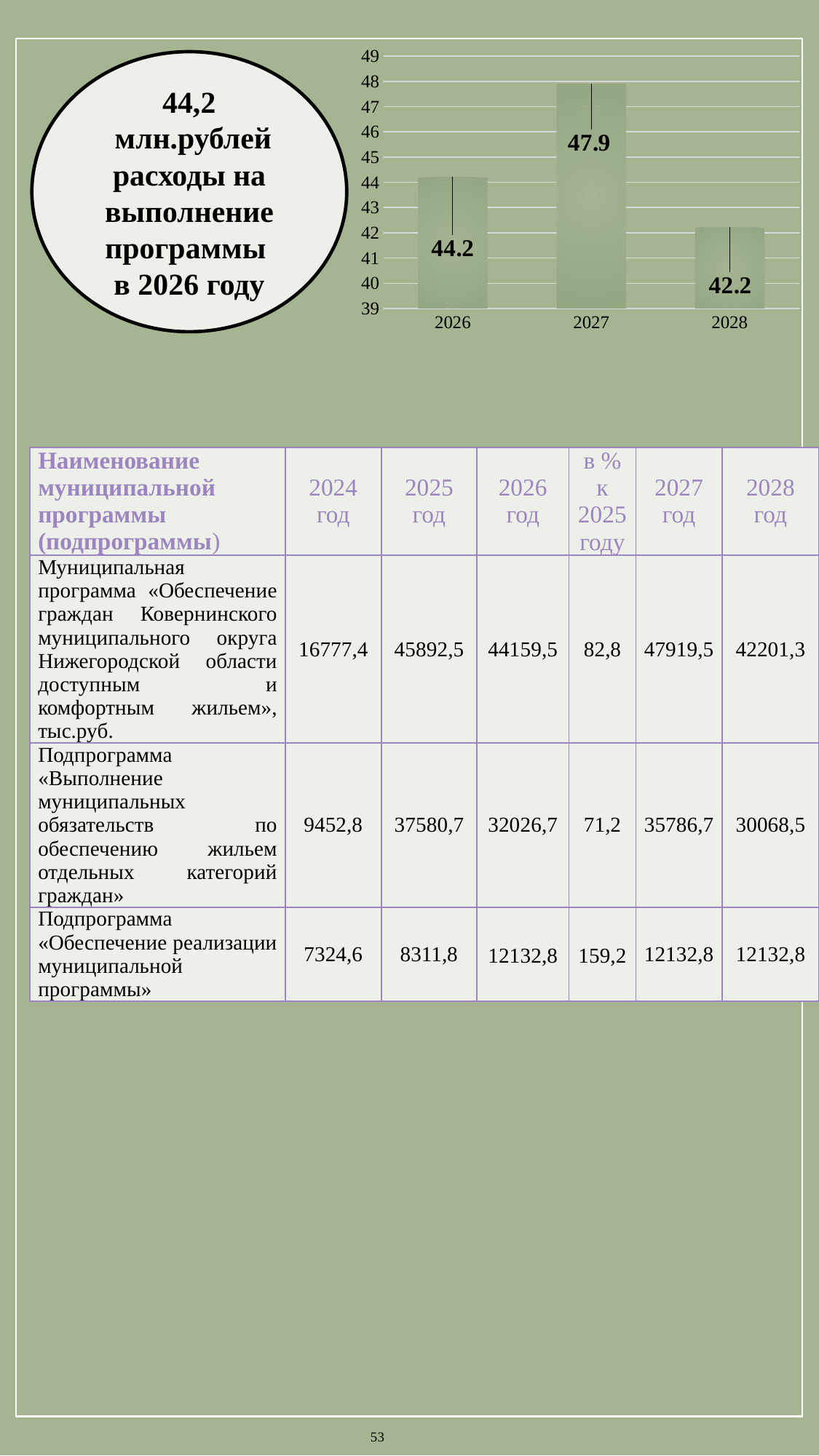
What type of chart is shown on the slide? bar chart What is the difference between the values for 2027 and 2028 in the bar chart? 5.7 How many bars are shown in the chart? 3 What is the value shown for 2028 in the bar chart? 42.2 Does the value in the bar chart rise or fall from 2027 to 2028? fall What is the value shown for 2026 in the bar chart? 44.2 Which year has the lowest bar in the chart? 2028 What is the difference between the values for 2027 and 2026 in the bar chart? 3.7 Which is larger in the bar chart, the value for 2026 or the value for 2028? 2026 Which year has the highest bar in the chart? 2027 Is the value for 2027 in the bar chart greater or less than 46? greater What is the value shown for 2027 in the bar chart? 47.9